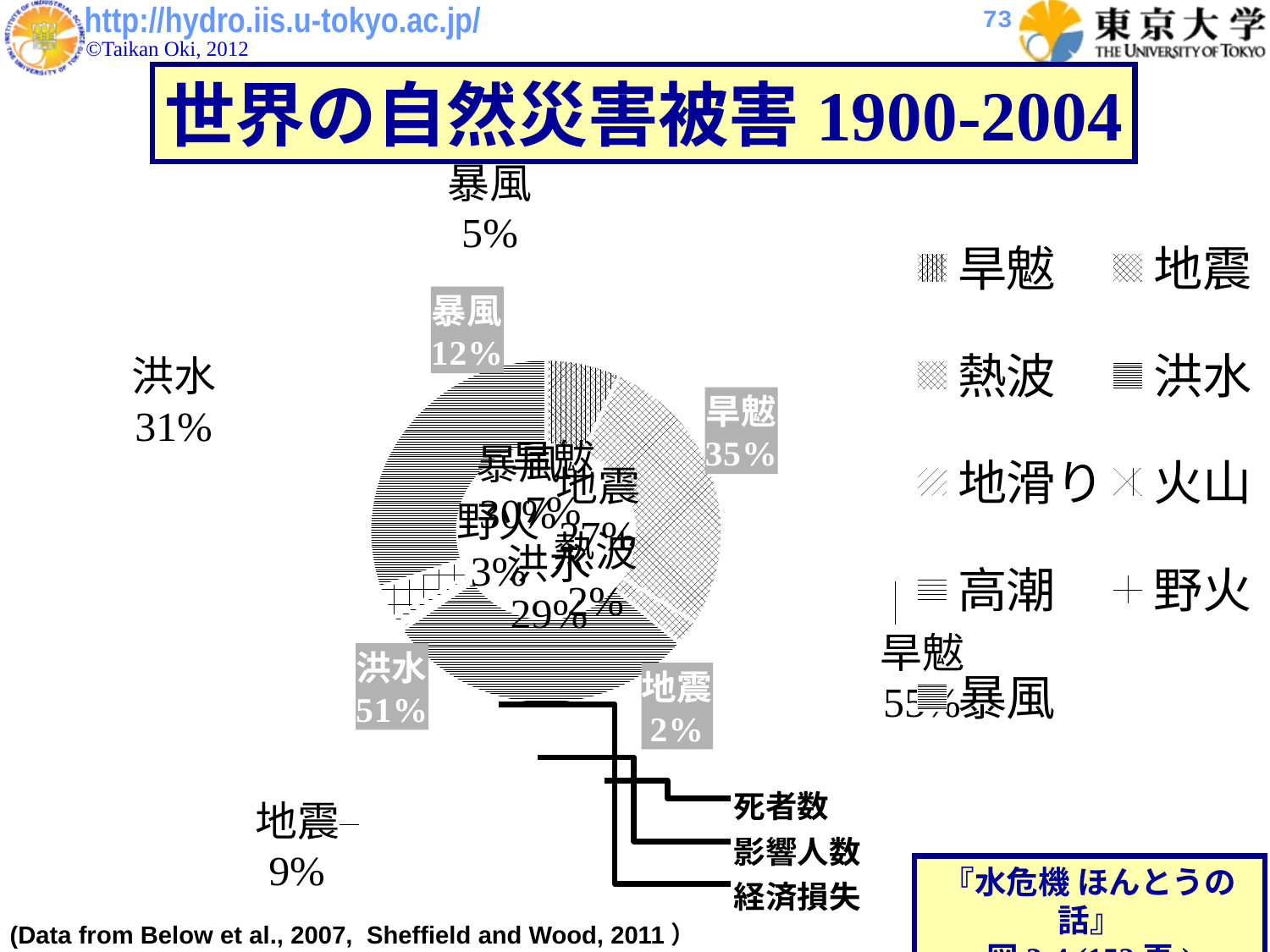
What are the three series names written at the ends of the connector lines below the pie chart? 死者数, 影響人数, 経済損失 In the pie chart, what percentage is shown in the gray-boxed label for 地震? 2% Among the outer black-text labels of the pie chart, which is larger: 洪水 at 31% or 地震 at 9%? 洪水 What is the difference in percentage points between the gray-boxed labels for 洪水 (51%) and 旱魃 (35%)? 16 What kind of chart is shown on the slide? doughnut chart In the pie chart, what percentage is shown in the gray-boxed label for 旱魃? 35% In the pie chart, what percentage is shown in the gray-boxed label for 洪水? 51% Among the gray-boxed labels on the pie chart (暴風, 旱魃, 洪水, 地震), which category has the largest percentage? 洪水 Among the gray-boxed labels on the pie chart (暴風, 旱魃, 洪水, 地震), which category has the smallest percentage? 地震 What is the title of the slide containing the pie chart? 世界の自然災害被害 1900-2004 In the pie chart, what percentage is shown in the gray-boxed label for 暴風? 12%